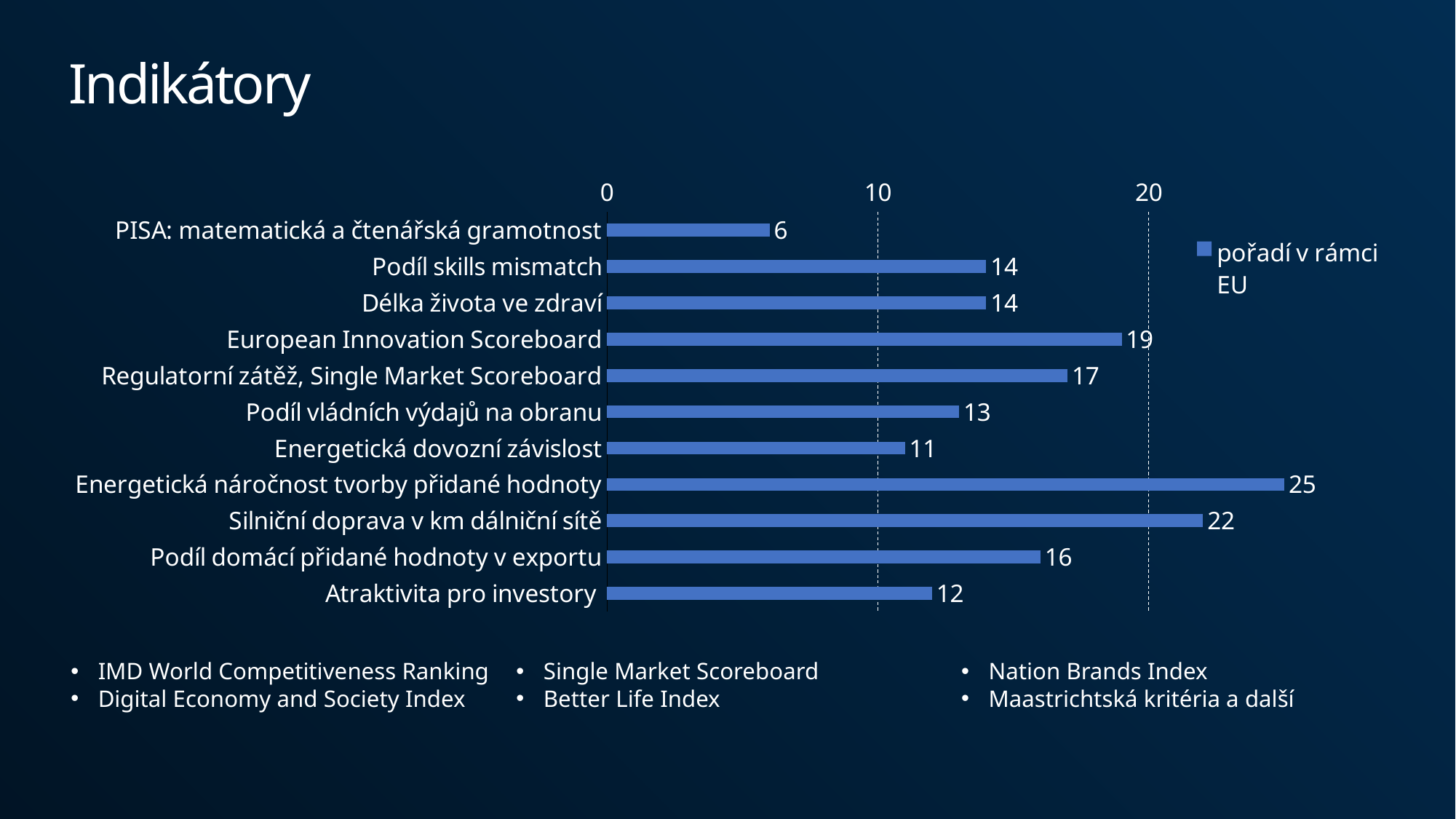
What is the value for 'PISA: matematická a čtenářská gramotnost'? 6 What is the value for 'Silniční doprava v km dálniční sítě'? 22 What is the legend entry of the chart? pořadí v rámci EU Is the value for 'Podíl vládních výdajů na obranu' greater or less than 10? greater Which category has the highest value? Energetická náročnost tvorby přidané hodnoty How many series does the legend list? 1 How many categories are shown in the chart? 11 What is the value for 'Energetická dovozní závislost'? 11 What is the difference between the values for 'European Innovation Scoreboard' and 'Atraktivita pro investory'? 7 Which category has the lowest value? PISA: matematická a čtenářská gramotnost What kind of chart is shown on the slide? bar chart Which is larger: the value for 'Regulatorní zátěž, Single Market Scoreboard' or the value for 'Podíl domácí přidané hodnoty v exportu'? Regulatorní zátěž, Single Market Scoreboard